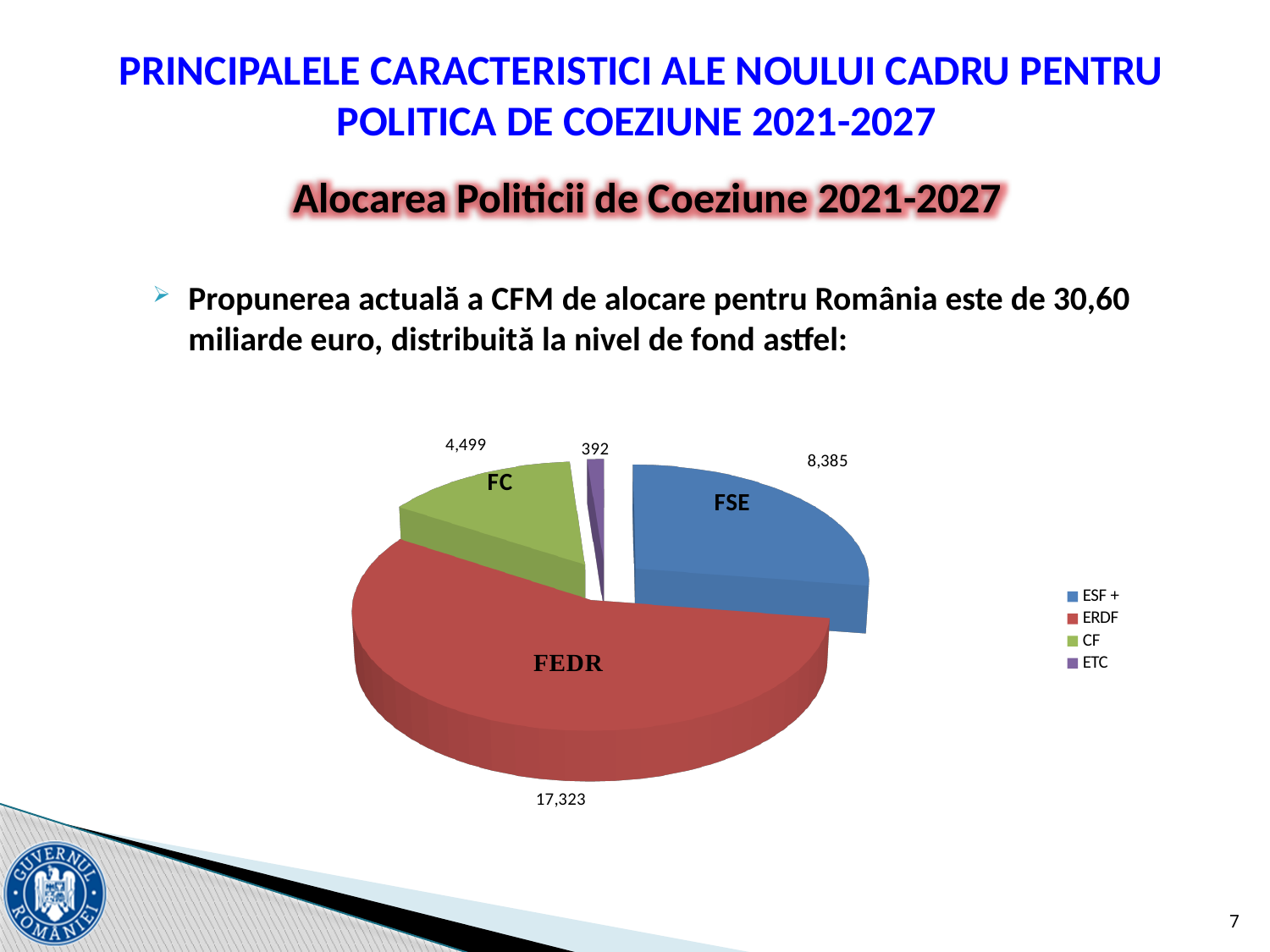
What is the value shown for the ETC slice? 392 What is the value shown for the FSE (ESF +) slice? 8,385 Which is larger, the FSE slice or the FC slice? FSE Which slice of the pie chart is the largest? FEDR (ERDF) How many slices does the pie chart have? 4 What type of chart is shown on the slide? Pie chart What is the value shown for the FC (CF) slice? 4,499 What colour is the FEDR (ERDF) slice? Red What is the value shown for the FEDR (ERDF) slice? 17,323 How many entries does the legend list? 4 What is the difference between the FEDR value and the FSE value? 8,938 Which slice of the pie chart is the smallest? ETC